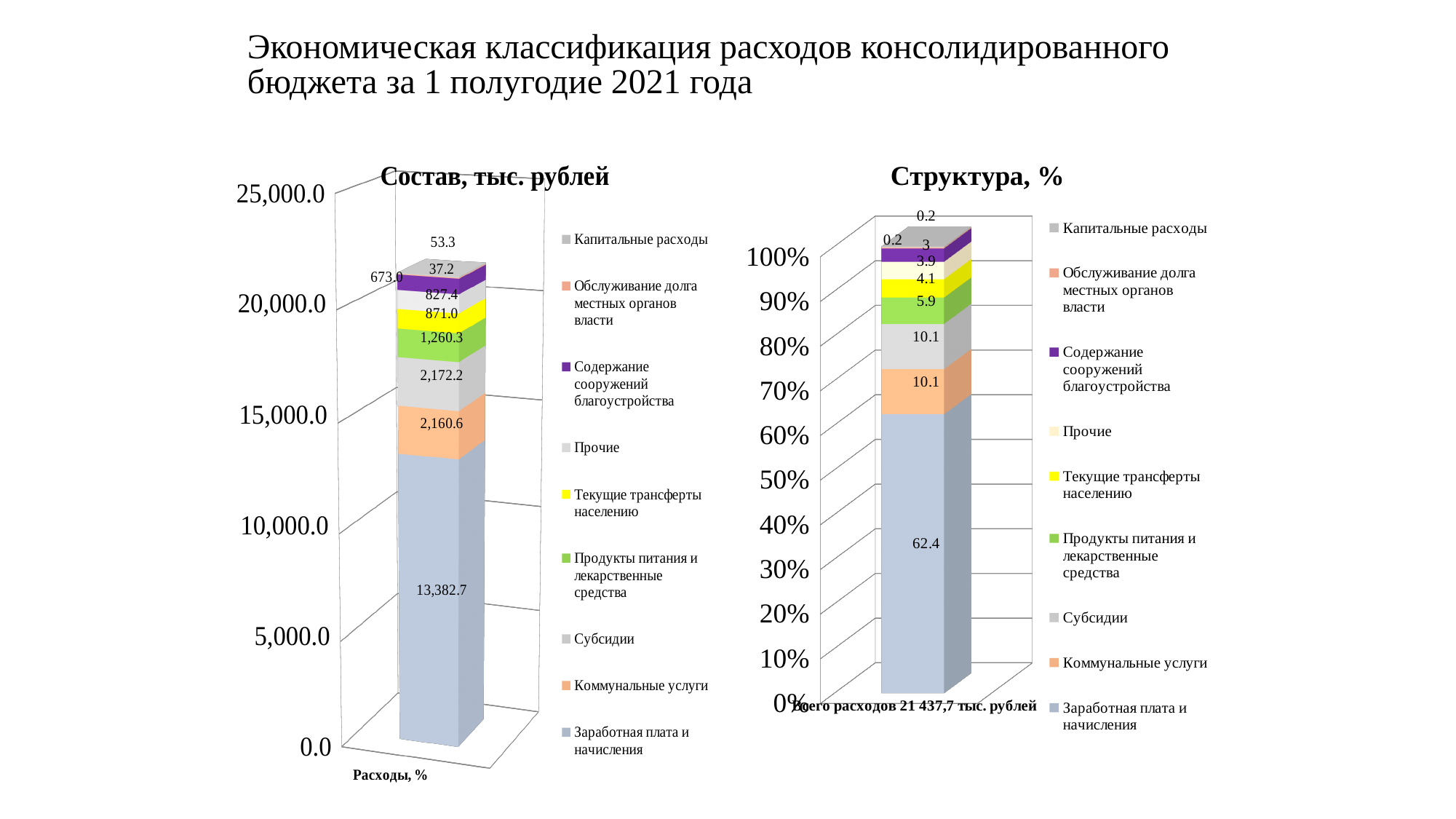
On the chart titled "Структура, %", what is the share for Заработная плата и начисления? 62.4 On the chart titled "Структура, %", what is the share for Продукты питания и лекарственные средства? 5.9 What kind of chart is the chart titled "Состав, тыс. рублей"? Stacked bar chart On the chart titled "Состав, тыс. рублей", what is the difference between Субсидии and Коммунальные услуги? 11.6 How many series does the legend of the chart titled "Структура, %" list? 9 On the chart titled "Состав, тыс. рублей", what is the value for Заработная плата и начисления? 13,382.7 On the chart titled "Состав, тыс. рублей", what is the value for Субсидии? 2,172.2 On the chart titled "Состав, тыс. рублей", which category has the largest value? Заработная плата и начисления On the chart titled "Состав, тыс. рублей", which is larger: Текущие трансферты населению or Прочие? Текущие трансферты населению On the chart titled "Состав, тыс. рублей", what is the total of the stacked bar? 21,437.7 On the chart titled "Состав, тыс. рублей", what is the value for Продукты питания и лекарственные средства? 1,260.3 On the chart titled "Структура, %", is the share for Заработная плата и начисления greater or less than 60%? greater